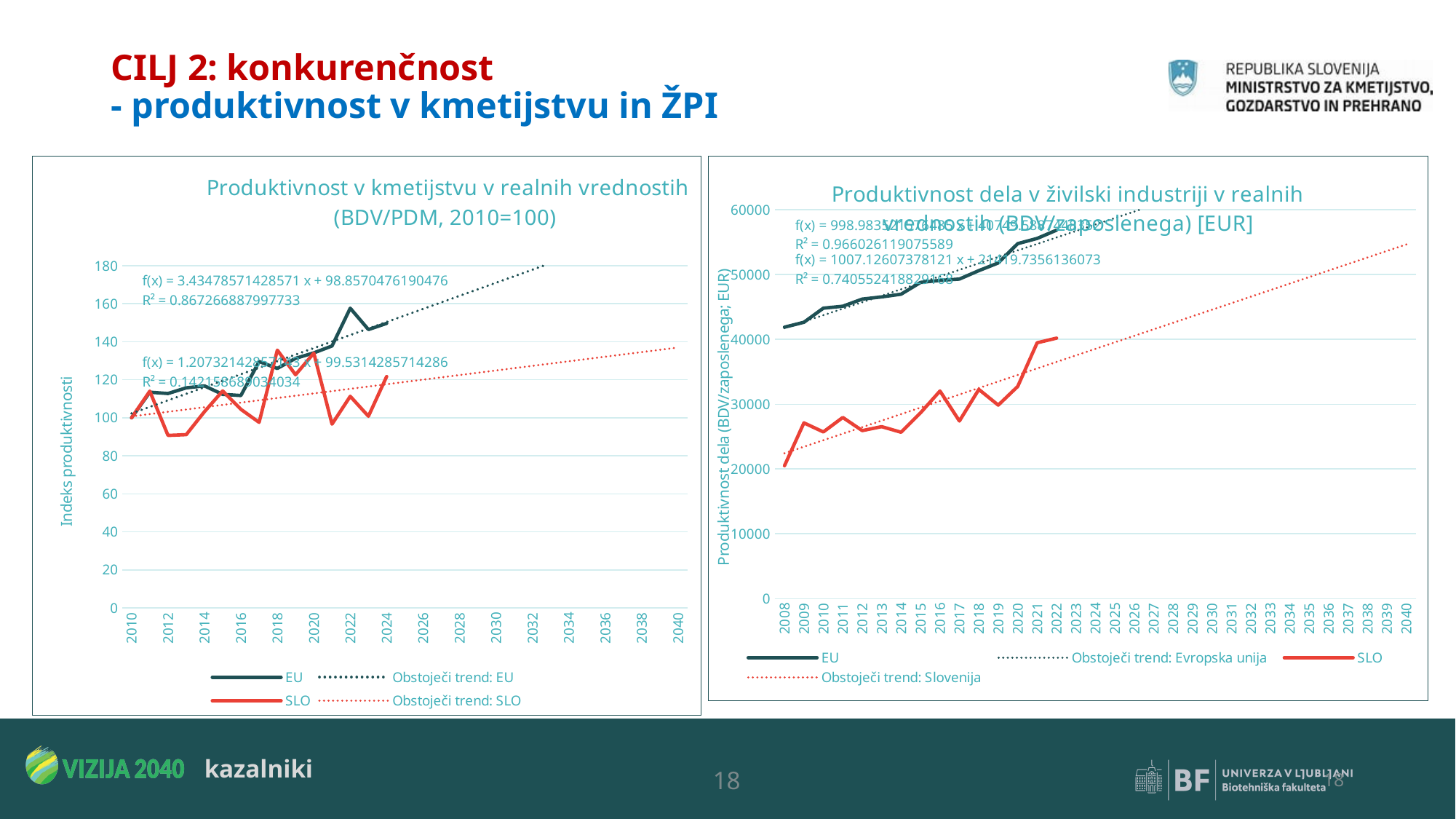
In the left chart, does the EU line generally rise or fall from 2010 to 2024? rise In the right chart, is the SLO value for 2014 greater or less than 30000? less What is the y-axis label of the left chart? Indeks produktivnosti What kind of chart is the left chart, 'Produktivnost v kmetijstvu v realnih vrednostih'? line chart In the right chart, which series is higher in 2008, EU or SLO? EU In the left chart, is the SLO value for 2012 greater or less than 100? less In the right chart, does the EU line rise or fall from 2008 to 2022? rise How many series does the legend of the left chart list? 4 In the left chart, is the EU value for 2022 greater or less than 140? greater In the left chart, which series is higher in 2022, EU or SLO? EU How many series does the legend of the right chart, 'Produktivnost dela v živilski industriji', list? 4